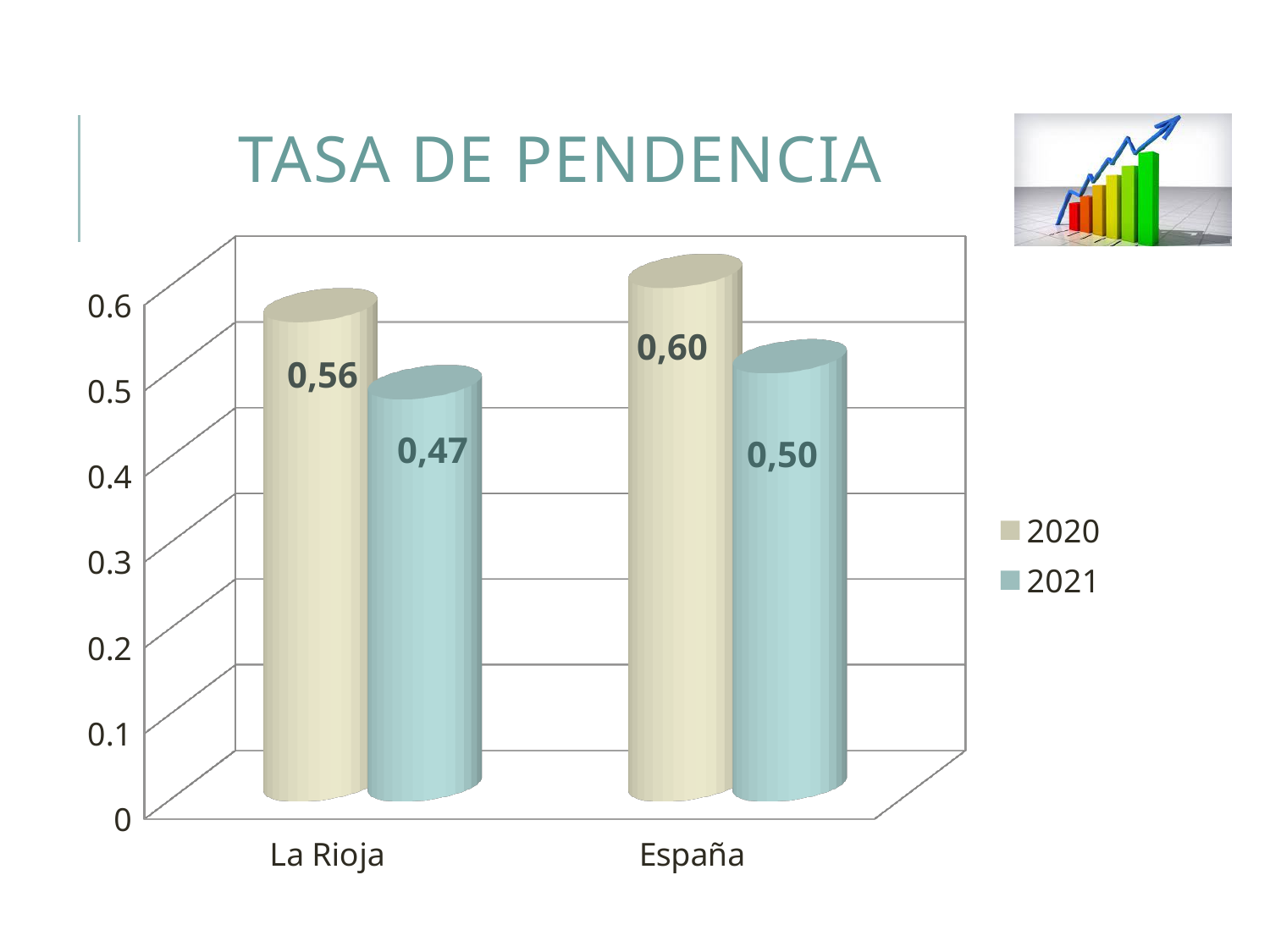
What is the difference between the 2020 and 2021 values for La Rioja? 0,09 What is the value for España in 2021? 0,50 How many series does the legend list? 2 What is the title of the chart? TASA DE PENDENCIA Which category has the highest value in the 2020 series? España Which is larger: the 2021 value for La Rioja or the 2021 value for España? España What kind of chart is shown on the slide? Bar chart How many categories are shown on the x axis? 2 What is the value for La Rioja in 2021? 0,47 What is the difference between the 2020 and 2021 values for España? 0,10 What is the value for La Rioja in 2020? 0,56 Which category has the lowest value in the 2021 series? La Rioja